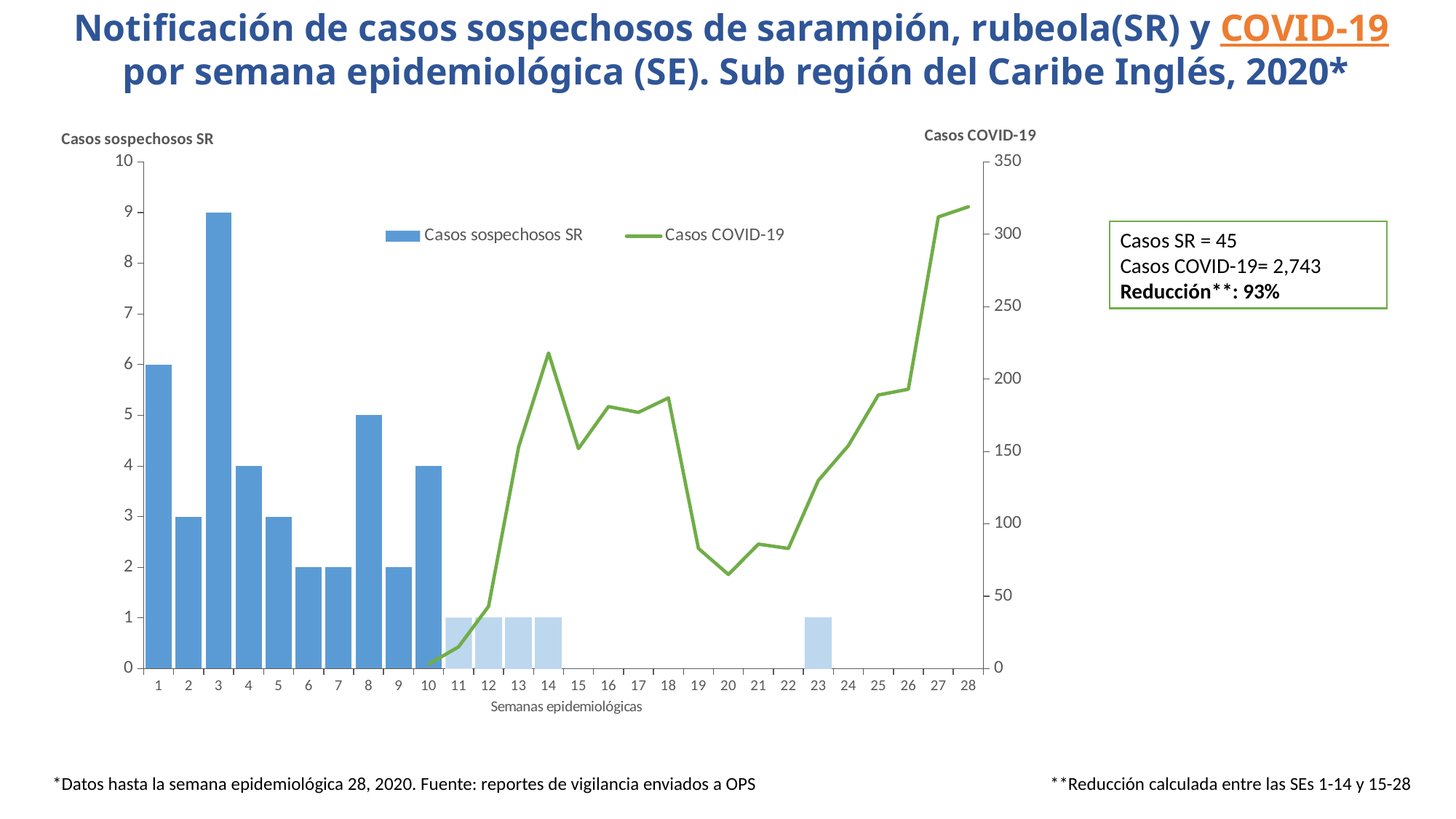
Which has more Casos sospechosos SR, week 4 or week 8? Week 8 What kind of chart is shown on the slide? A combined bar and line chart How many epidemiological weeks are shown on the x axis? 28 Is the value of Casos COVID-19 in week 20 greater or less than 100? less How many series does the legend list? 2 What is the value of Casos sospechosos SR in epidemiological week 8? 5 What is the label of the right-hand vertical axis? Casos COVID-19 What is the difference between Casos sospechosos SR in week 3 and week 1? 3 Is the value of Casos COVID-19 in week 28 greater or less than 300? greater What is the value of Casos sospechosos SR in epidemiological week 1? 6 In which epidemiological week is the number of Casos sospechosos SR highest? 3 What is the value of Casos sospechosos SR in epidemiological week 3? 9